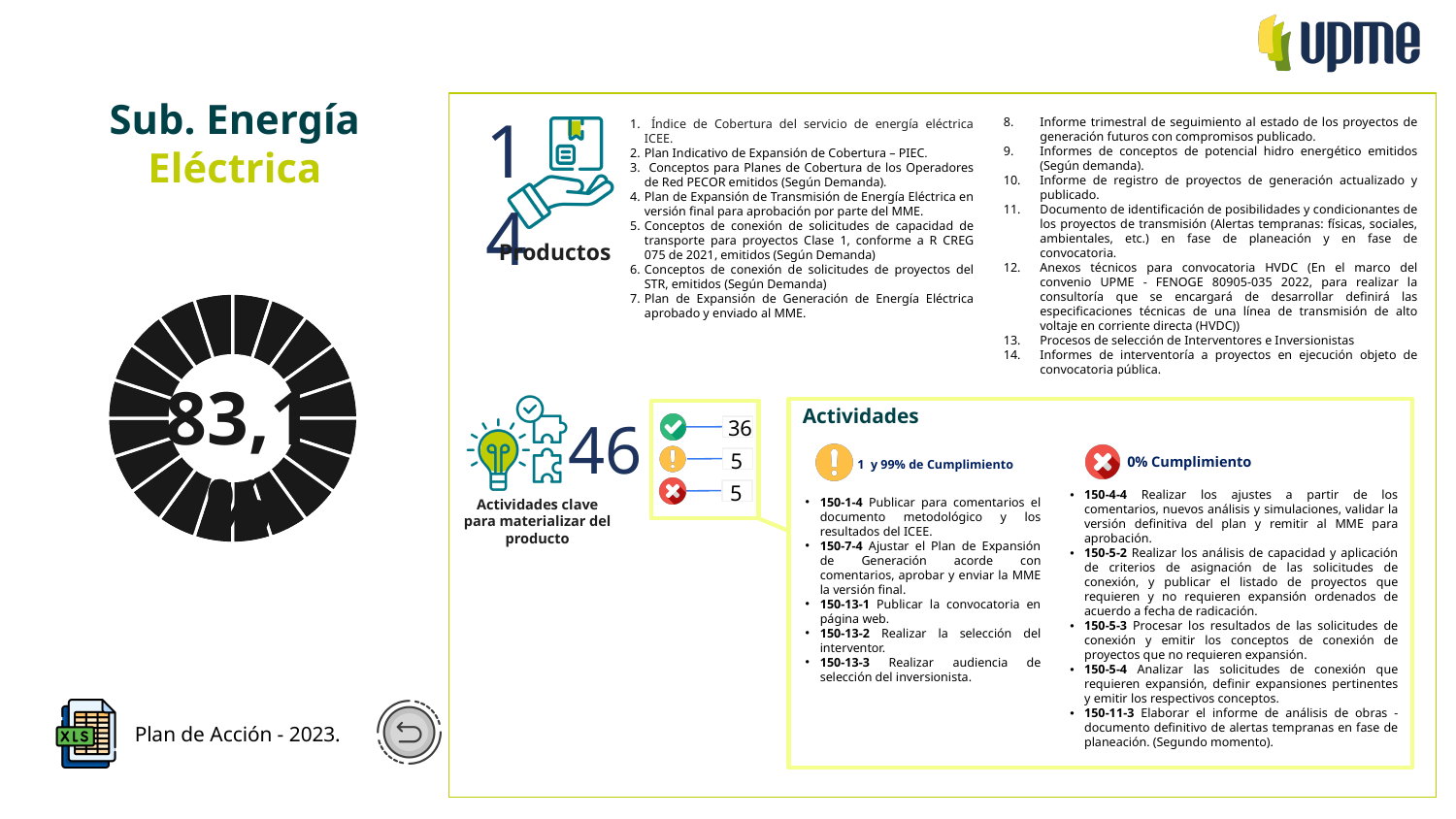
In the activity status indicator next to the '46' figure, what number is shown beside the red X icon? 5 In the activity status indicator, which status has the highest count? green check (36) In the activity status indicator, what is the difference between the green check count and the red X count? 31 In the activity status indicator, what is the total of the three counts shown? 46 Is the value shown in the centre of the doughnut chart greater or less than 90? less What kind of chart is the circular chart on the left of the slide? doughnut chart Does the doughnut chart have a legend? No What value is displayed in the centre of the circular chart on the left of the slide? 83,1 What colour are the segments of the doughnut chart? black In the activity status indicator next to the '46' figure, what number is shown beside the yellow warning icon? 5 Is the value shown in the centre of the doughnut chart greater or less than 80? greater In the activity status indicator next to the '46' figure, what number is shown beside the green check icon? 36